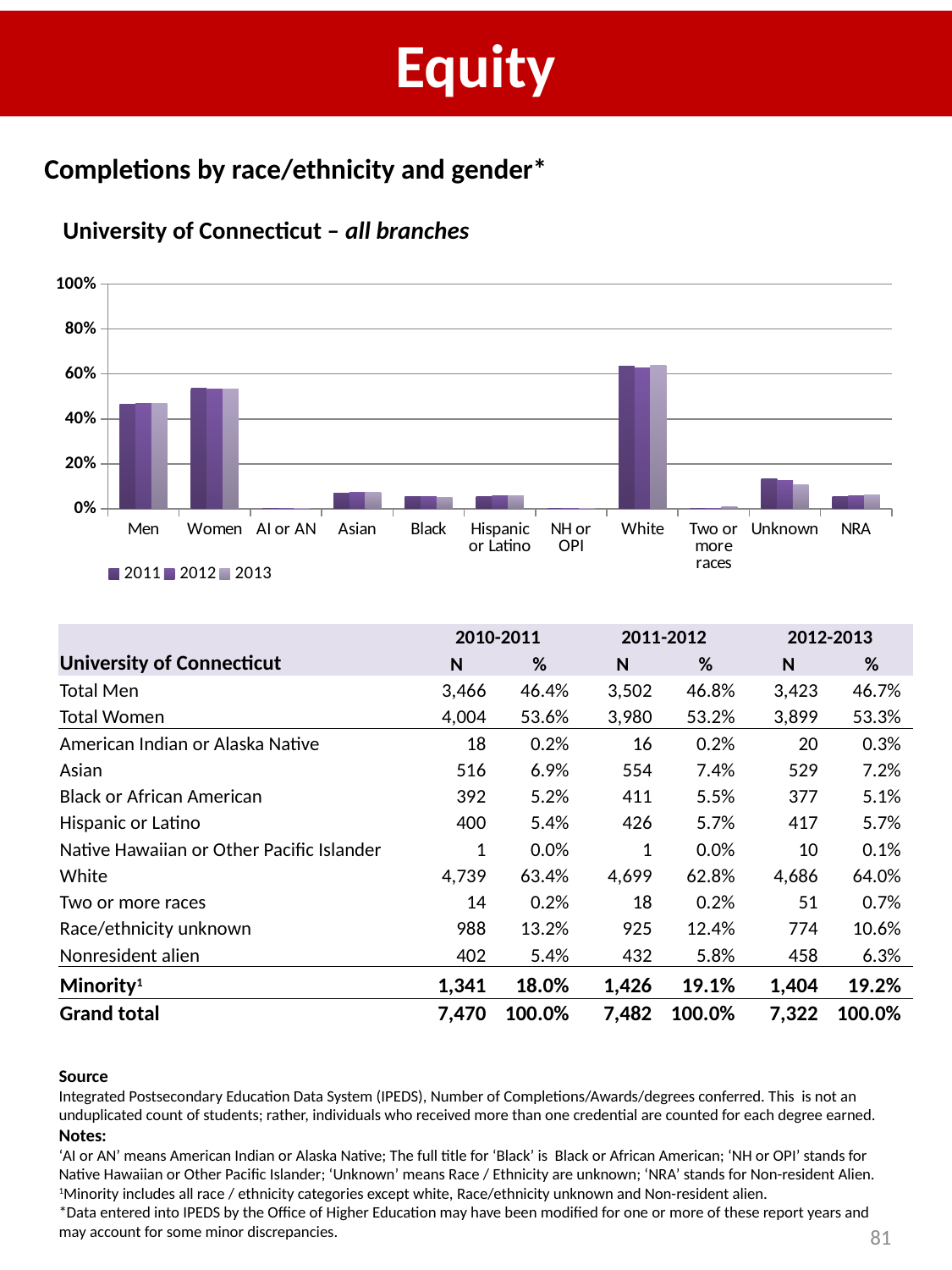
What kind of chart is shown on the slide? bar chart Which category has the highest bars in the chart? White Is the 2012 value for Unknown in the chart greater or less than 20%? less According to the table, what percentage of completions were White in 2012-2013? 64.0% How many series does the chart legend list? 3 Is the 2013 value for Men in the chart greater or less than 40%? greater Is the 2011 value for White in the chart greater or less than 60%? greater According to the table, what is the difference between Total Women and Total Men N in 2012-2013? 476 In the chart, which is larger for 2011: the value for Men or the value for Women? Women How many categories are shown along the x axis of the chart? 11 What are the legend entries of the chart? 2011, 2012, 2013 According to the table, what is the Grand total N for 2010-2011? 7,470